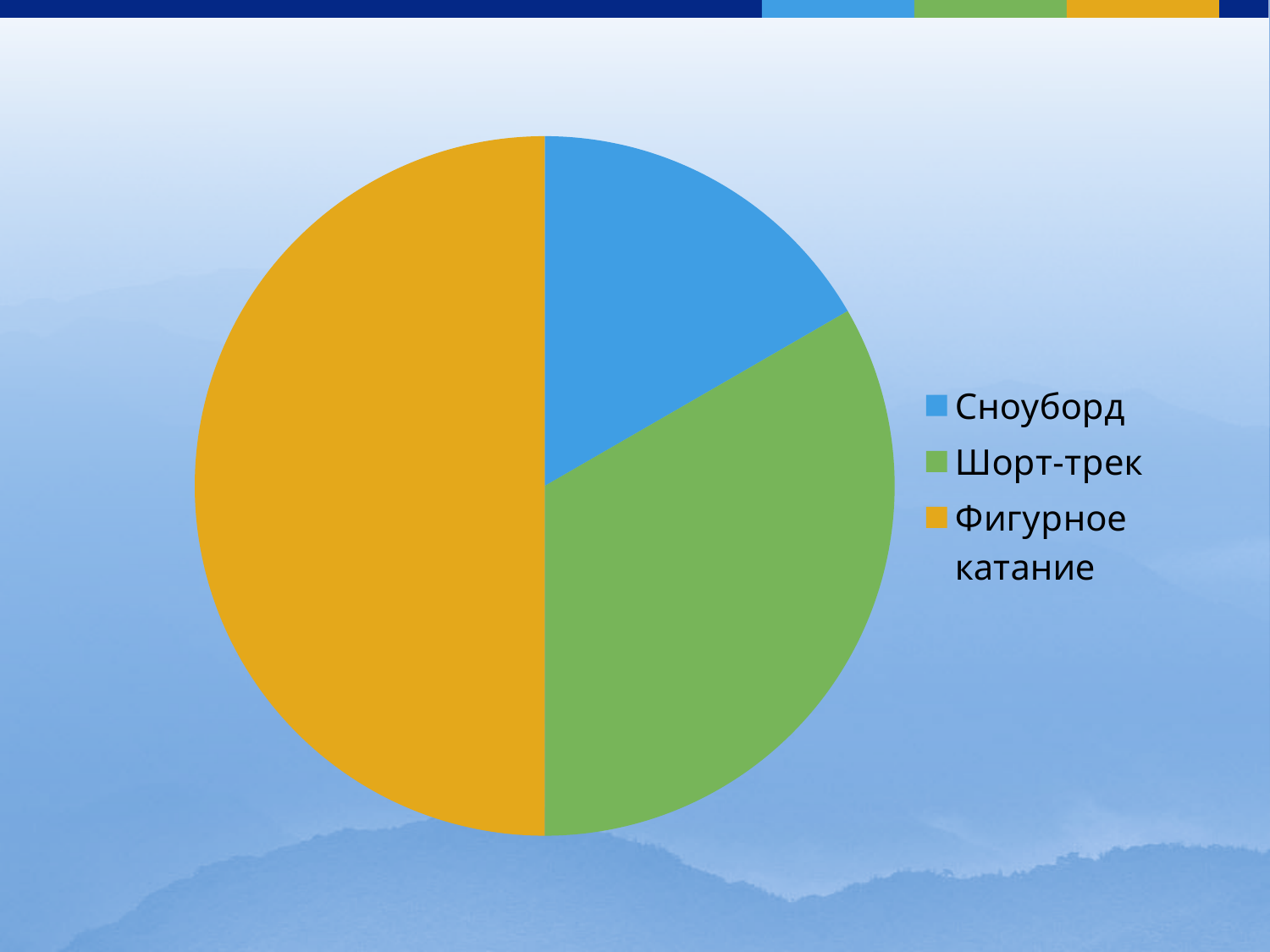
What colour is the slice for Сноуборд in the pie chart? blue How many slices does the pie chart have? 3 How many entries does the legend of the pie chart list? 3 What kind of chart is shown on the slide? pie chart Which category has the smallest slice of the pie chart? Сноуборд Which slice is larger, Сноуборд or Шорт-трек? Шорт-трек Which category is shown in orange in the pie chart? Фигурное катание Which category has the largest slice of the pie chart? Фигурное катание Which slice is larger, Шорт-трек or Фигурное катание? Фигурное катание